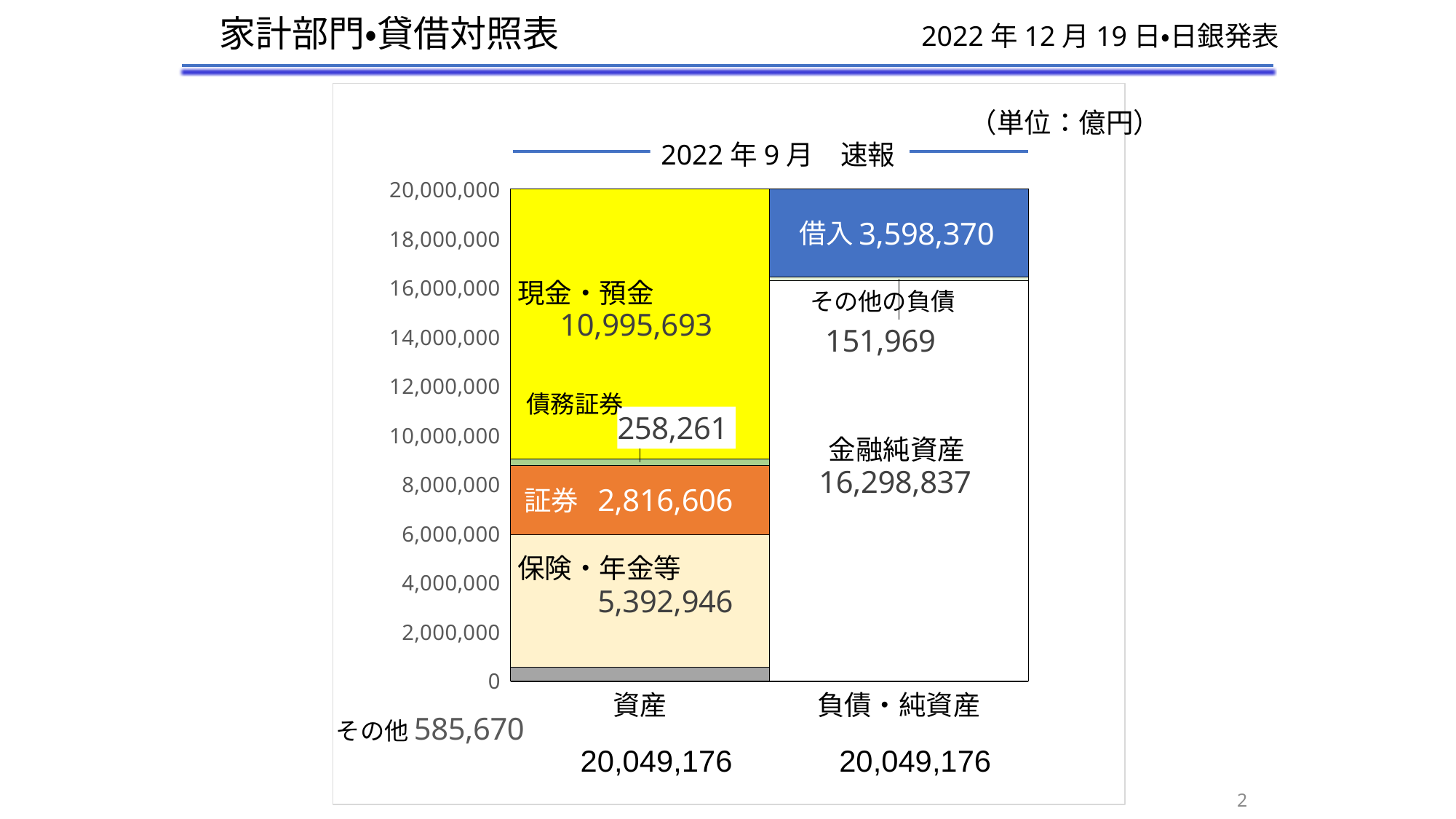
Which segment of the 資産 bar is the largest? 現金・預金 What is the value of その他の負債? 151,969 How many bars (categories) are shown on the x axis? 2 What is the value of 借入 in the 負債・純資産 bar? 3,598,370 What is the value of 現金・預金 in the 資産 bar? 10,995,693 Which segment of the 資産 bar is the smallest? 債務証券 What is the difference between 現金・預金 and 保険・年金等? 5,602,747 What is the total of the 資産 bar? 20,049,176 Which is larger, 借入 or 証券? 借入 What is the value of 金融純資産? 16,298,837 What is the value of 保険・年金等? 5,392,946 What kind of chart is shown? Stacked bar chart